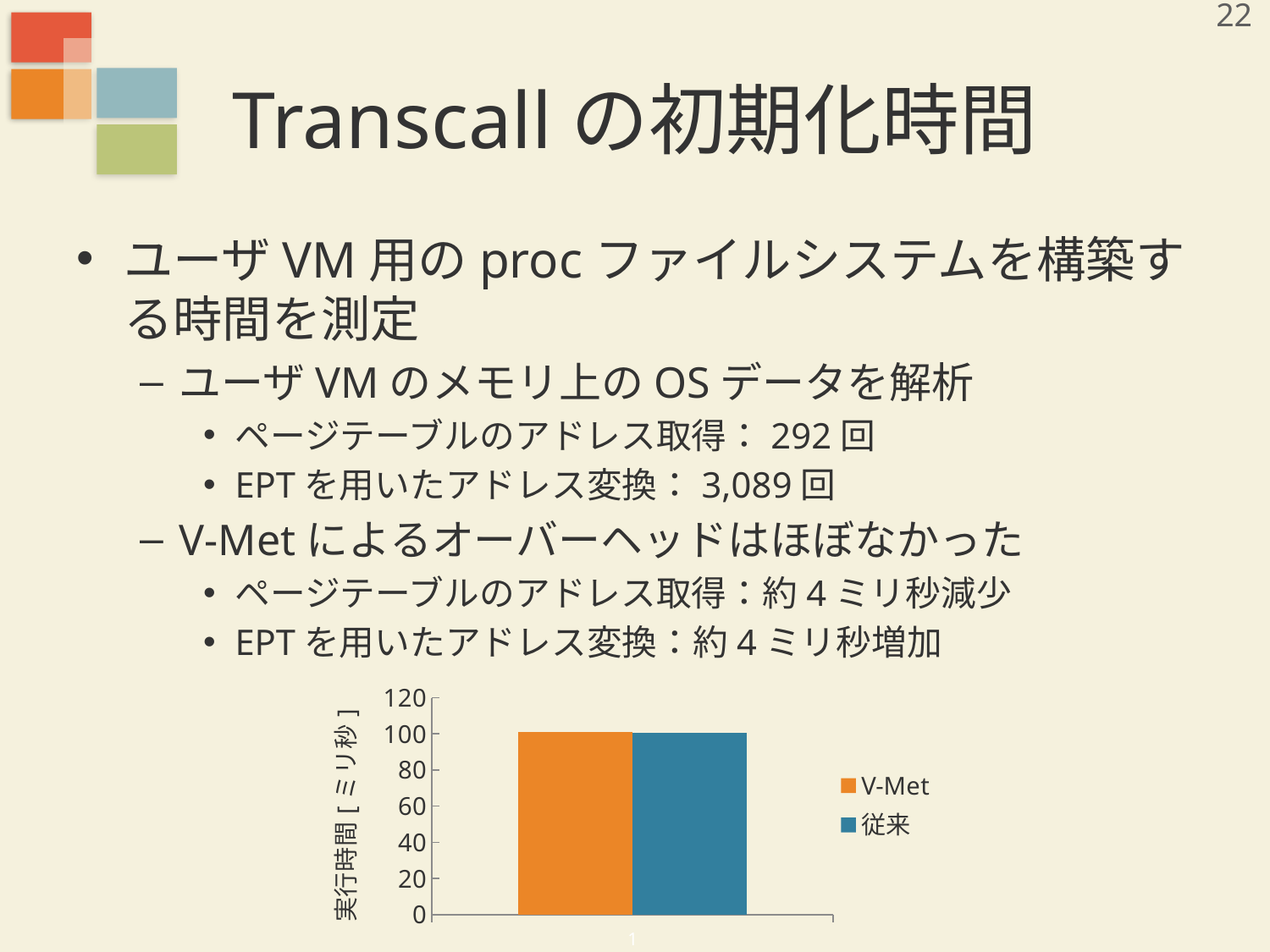
Is the value for V-Met greater or less than 80? greater Is the value for 従来 greater or less than 120? less How many series does the chart's legend list? 2 Is the value for V-Met greater or less than 60? greater What is the label on the chart's vertical axis? 実行時間 [ミリ秒] How many categories are plotted along the x axis of the chart? 1 What kind of chart is shown on the slide? bar chart What are the two series named in the chart's legend? V-Met and 従来